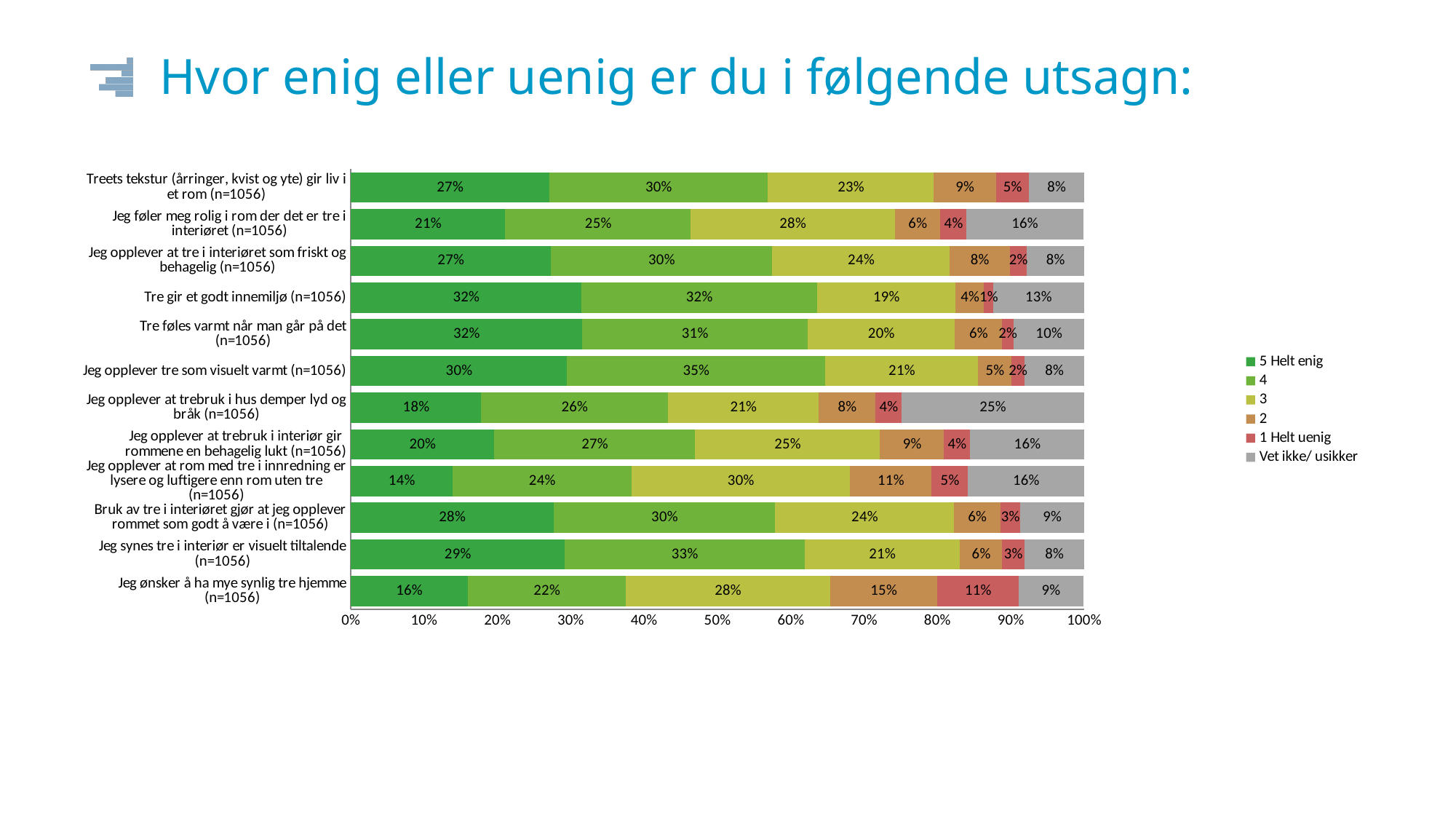
What is the value for "Vet ikke/ usikker" for "Jeg opplever at trebruk i hus demper lyd og bråk (n=1056)"? 25% How many series does the legend list? 6 Which legend entry is shown in grey? Vet ikke/ usikker Which statement has the highest value for "Vet ikke/ usikker"? Jeg opplever at trebruk i hus demper lyd og bråk (n=1056) Which statement has the highest value for "1 Helt uenig"? Jeg ønsker å ha mye synlig tre hjemme (n=1056) What type of chart is shown on the slide? stacked bar chart How many statements (categories) are plotted in the chart? 12 What is the difference between the "3" value for "Jeg føler meg rolig i rom der det er tre i interiøret (n=1056)" and the "3" value for "Tre gir et godt innemiljø (n=1056)"? 9% What is the value for "4" for "Jeg opplever tre som visuelt varmt (n=1056)"? 35% Which statement has the lowest value for "5 Helt enig"? Jeg opplever at rom med tre i innredning er lysere og luftigere enn rom uten tre (n=1056) Which is larger: the "2" value for "Jeg ønsker å ha mye synlig tre hjemme (n=1056)" or the "2" value for "Treets tekstur (årringer, kvist og yte) gir liv i et rom (n=1056)"? Jeg ønsker å ha mye synlig tre hjemme (n=1056) What is the value for "5 Helt enig" for "Jeg ønsker å ha mye synlig tre hjemme (n=1056)"? 16%